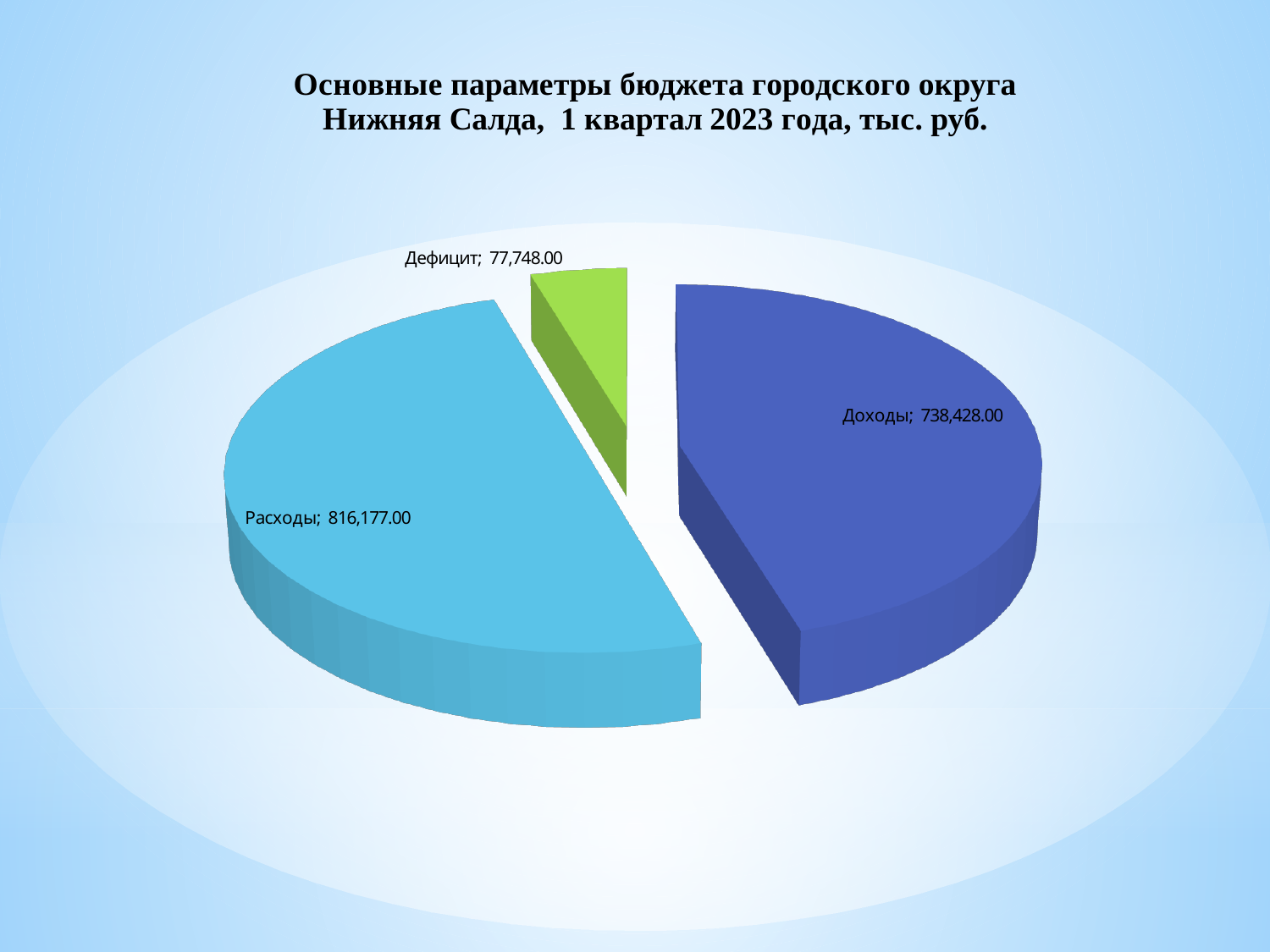
What is the difference between Расходы and Доходы? 77,749.00 Which is larger, Расходы or Доходы? Расходы Which category has the largest slice of the pie? Расходы What is the value for Расходы? 816,177.00 What is the difference between Доходы and Дефицит? 660,680.00 What kind of chart is shown on the slide? Pie chart What is the value for Доходы? 738,428.00 What is the value for Дефицит? 77,748.00 What share of the pie does Дефицит represent, to one decimal place? 4.8% Which category has the smallest slice of the pie? Дефицит How many slices does the pie chart have? 3 What colour is the Дефицит slice? Green